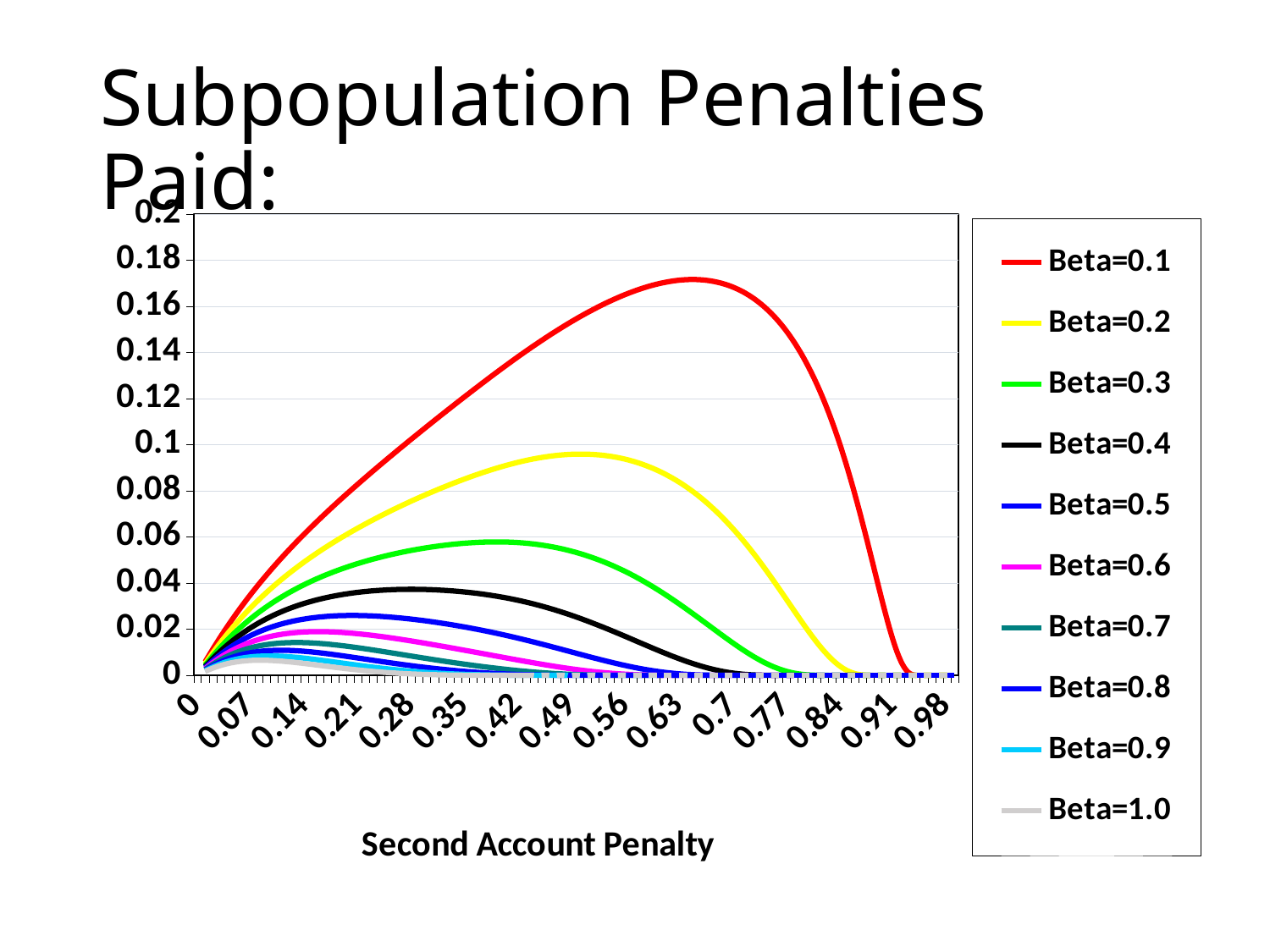
Does the Beta=0.1 line rise or fall between a Second Account Penalty of 0.7 and 0.91? Fall How many series does the legend list? 10 Is the peak value of the Beta=0.2 line greater or less than 0.1? less Which series reaches the highest peak value? Beta=0.1 What kind of chart is shown on the slide? Line chart What is the title of the x axis? Second Account Penalty Is the peak value of the Beta=0.4 line greater or less than 0.06? less What colour is the Beta=0.1 line? Red Is the peak value of the Beta=0.1 line greater or less than 0.16? greater How many tick labels are shown on the x axis? 15 At a Second Account Penalty of 0.49, which line is higher: Beta=0.1 or Beta=0.2? Beta=0.1